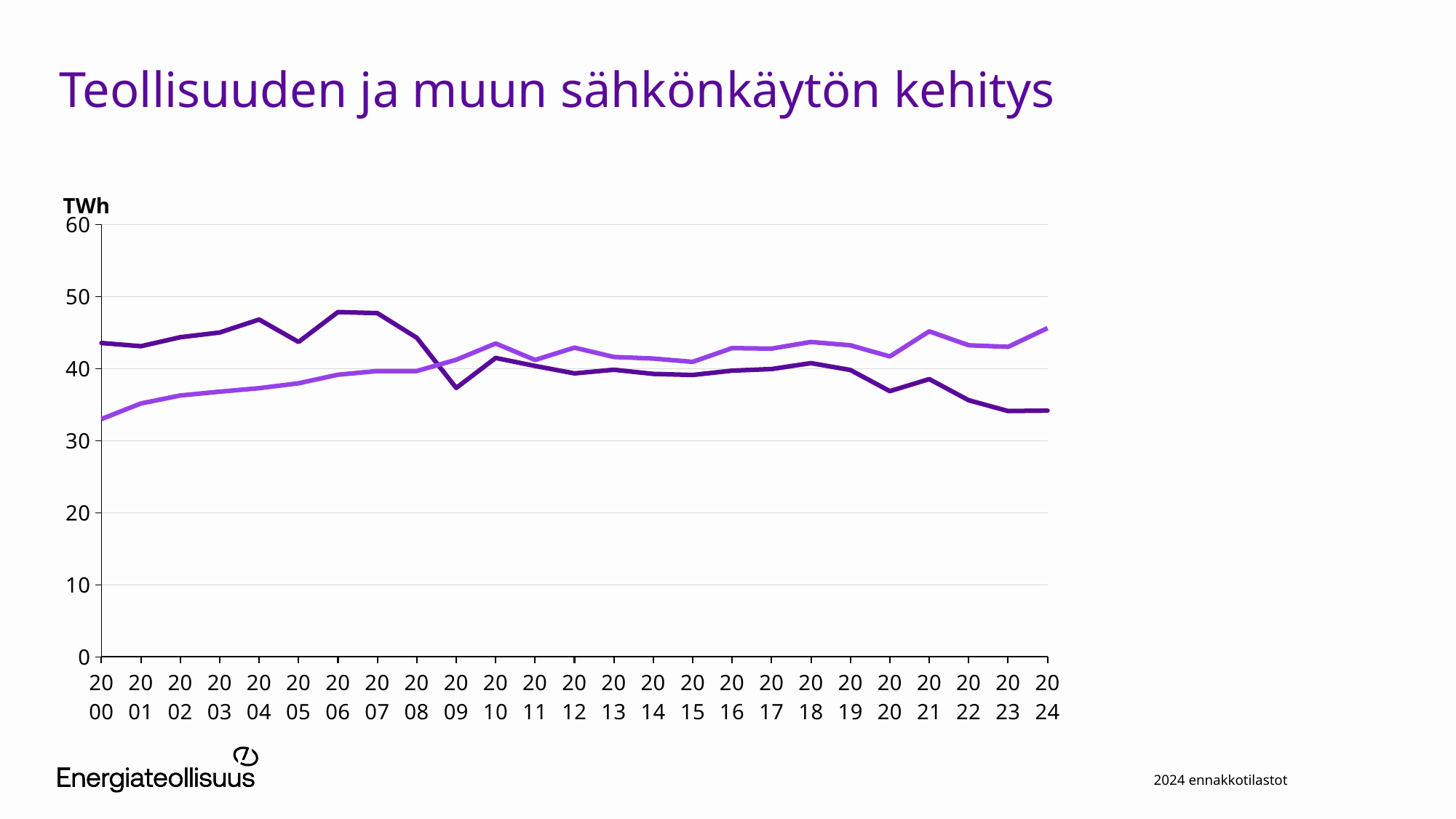
What is the title of the chart? Teollisuuden ja muun sähkönkäytön kehitys In 2006, which line has the higher value, the dark purple or the light purple line? dark purple Is the value of the dark purple line in 2000 greater or less than 40 TWh? greater Is the value of the light purple line in 2000 greater or less than 40 TWh? less What kind of chart is shown on the slide? Line chart Is the value of the dark purple line in 2024 greater or less than 40 TWh? less How many years are plotted along the x axis of the chart? 25 Does the dark purple line overall rise or fall from 2000 to 2024? fall What unit is shown on the vertical axis of the chart? TWh In 2024, which line has the higher value, the dark purple or the light purple line? light purple How many lines are plotted in the chart? 2